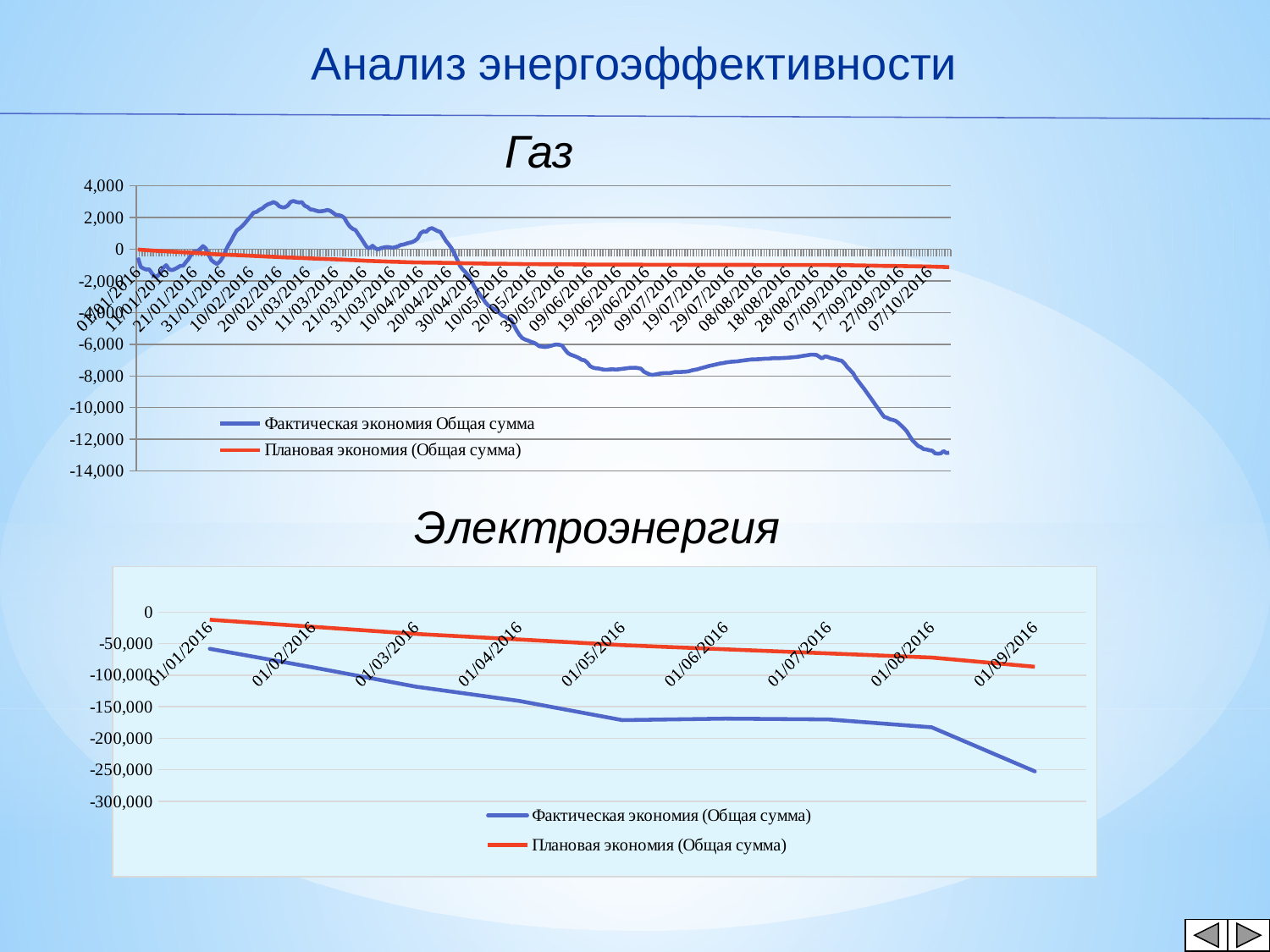
What kind of chart is the "Газ" chart? line chart In the "Газ" chart, which series has the higher value at 07/10/2016, "Фактическая экономия Общая сумма" or "Плановая экономия (Общая сумма)"? Плановая экономия (Общая сумма) In the "Электроэнергия" chart, is the value of "Фактическая экономия (Общая сумма)" at 01/09/2016 greater or less than -200,000? less In the "Электроэнергия" chart, does the "Фактическая экономия (Общая сумма)" line rise or fall from 01/01/2016 to 01/09/2016? fall What kind of chart is the "Электроэнергия" chart? line chart How many series does the legend of the "Электроэнергия" chart list? 2 In the "Электроэнергия" chart, how many dates are labelled on the x axis? 9 In the "Электроэнергия" chart, is the value of "Плановая экономия (Общая сумма)" at 01/09/2016 greater or less than -100,000? greater In the "Газ" chart, is the value of "Фактическая экономия Общая сумма" at 07/10/2016 greater or less than -10,000? less In the "Электроэнергия" chart, which series has the lower value at 01/05/2016, "Фактическая экономия (Общая сумма)" or "Плановая экономия (Общая сумма)"? Фактическая экономия (Общая сумма) In the "Газ" chart, what colour is the "Плановая экономия (Общая сумма)" line? red How many series does the legend of the "Газ" chart list? 2